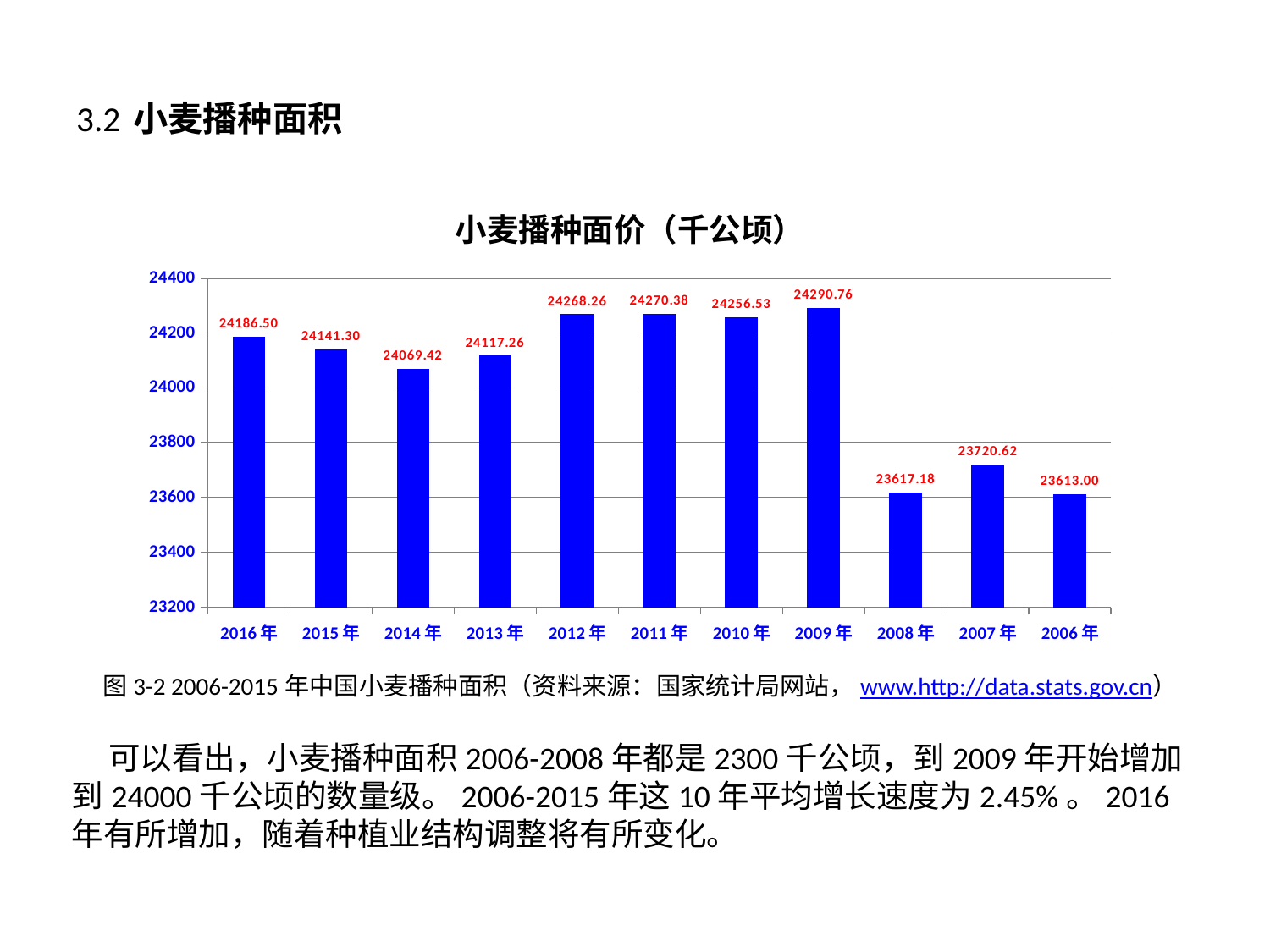
Is the value for 2014年 greater or less than 24200? less What kind of chart is this? bar chart What is the value for 2009年? 24290.76 What is the difference between the values for 2016年 and 2015年? 45.20 How many years are shown on the x axis? 11 Which year has the highest value? 2009年 What is the value for 2013年? 24117.26 Which is larger, the value for 2007年 or the value for 2008年? 2007年 What is the value for 2008年? 23617.18 What is the difference between the values for 2009年 and 2008年? 673.58 What is the value for 2016年? 24186.50 Which year has the lowest value? 2006年